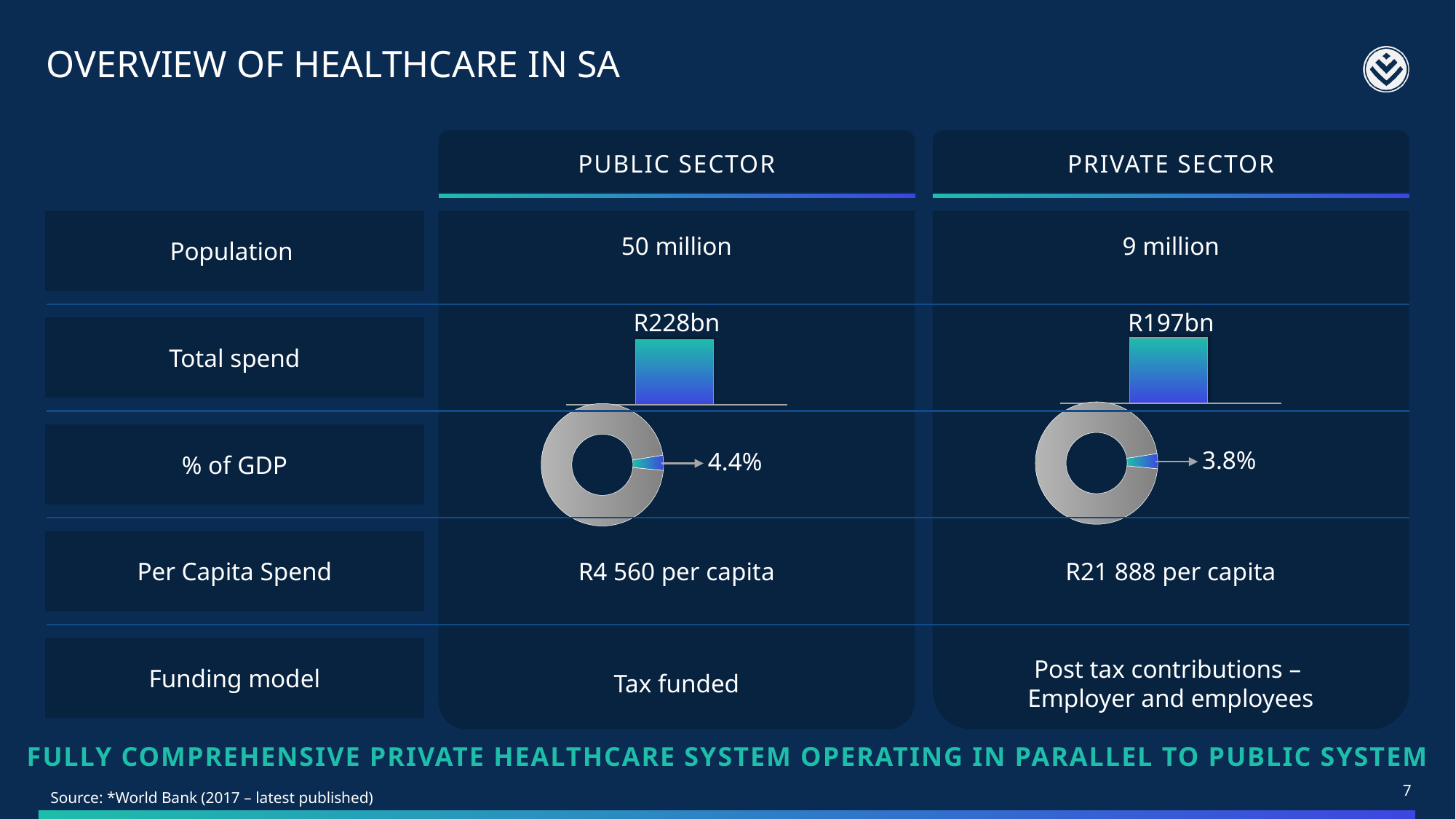
In the Total spend row, what is the difference between the Public Sector bar (R228bn) and the Private Sector bar (R197bn)? R31bn In the % of GDP row, which sector's donut chart shows the larger percentage, Public Sector or Private Sector? Public Sector What kind of chart is used in the Total spend row for each sector? Bar chart How many donut charts are shown on the slide? 2 In the % of GDP row, what value is labelled on the Private Sector donut chart? 3.8% What kind of chart is used in the % of GDP row for each sector? Donut chart In the % of GDP row, what value is labelled on the Public Sector donut chart? 4.4% In the % of GDP row, what is the difference between the Public Sector value (4.4%) and the Private Sector value (3.8%)? 0.6 percentage points In the Total spend row, what value is labelled on the Private Sector bar? R197bn In the Total spend row, what value is labelled on the Public Sector bar? R228bn In the % of GDP donut charts, what colour is the large remaining portion of each ring? Grey